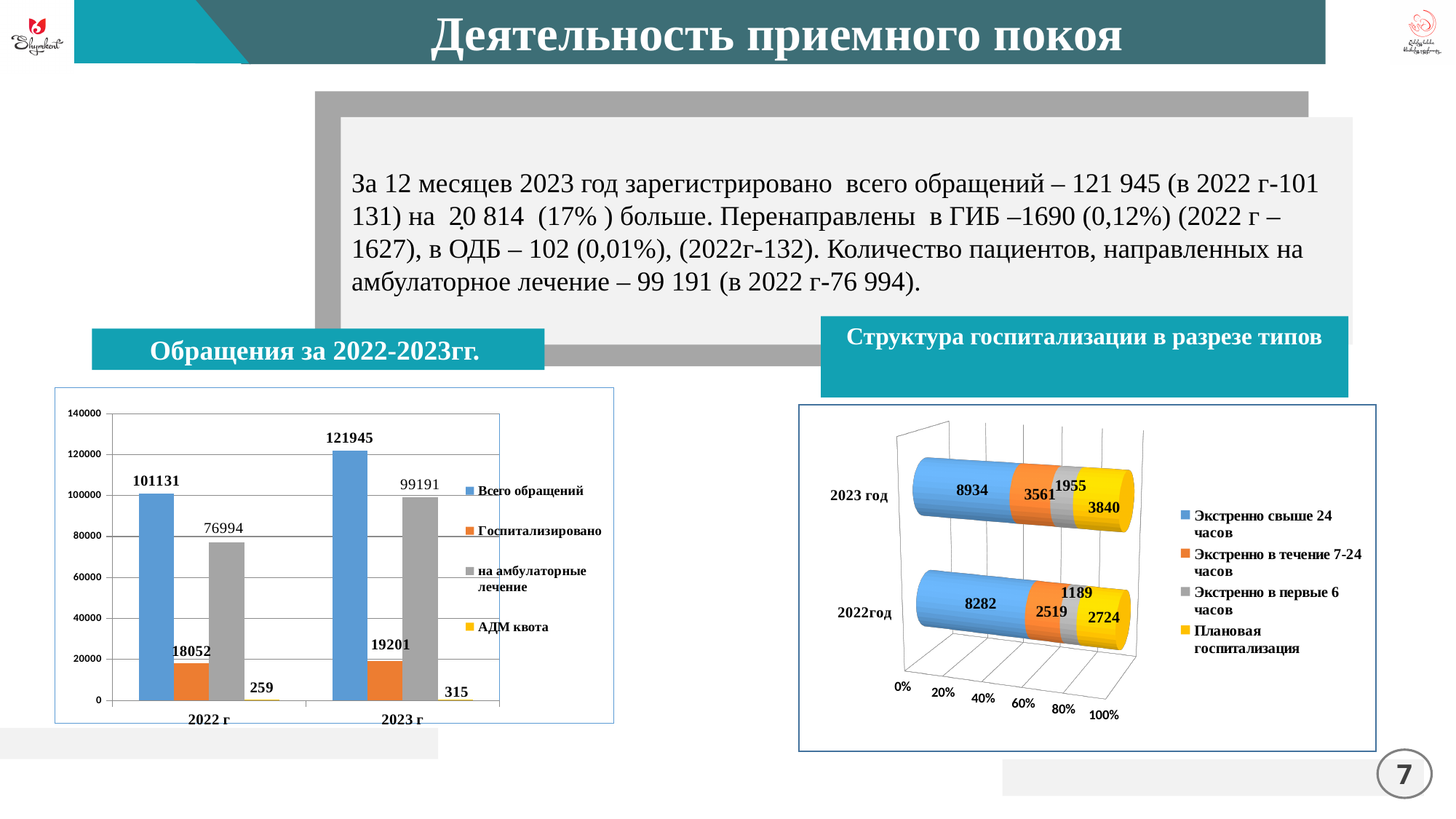
In the chart 'Обращения за 2022-2023гг.', by how much did 'Всего обращений' increase from 2022 г to 2023 г? 20814 In the chart 'Структура госпитализации в разрезе типов', which type has the highest value for 2023 год? Экстренно свыше 24 часов In the chart 'Структура госпитализации в разрезе типов', is 'Экстренно в течение 7-24 часов' larger for 2023 год or 2022год? 2023 год What kind of chart is 'Обращения за 2022-2023гг.'? Bar chart In the chart 'Обращения за 2022-2023гг.', what is the value of 'Госпитализировано' for 2022 г? 18052 In the chart 'Обращения за 2022-2023гг.', what is the value of 'АДМ квота' for 2023 г? 315 In the chart 'Структура госпитализации в разрезе типов', what is the value of 'Экстренно в первые 6 часов' for 2023 год? 1955 In the chart 'Обращения за 2022-2023гг.', how many series does the legend list? 4 In the chart 'Обращения за 2022-2023гг.', what is the value of 'Всего обращений' for 2023 г? 121945 In the chart 'Структура госпитализации в разрезе типов', what is the value of 'Плановая госпитализация' for 2022год? 2724 In the chart 'Обращения за 2022-2023гг.', which series has the lowest value for 2022 г? АДМ квота In the chart 'Структура госпитализации в разрезе типов', what is the total of all segments for 2022год? 14714